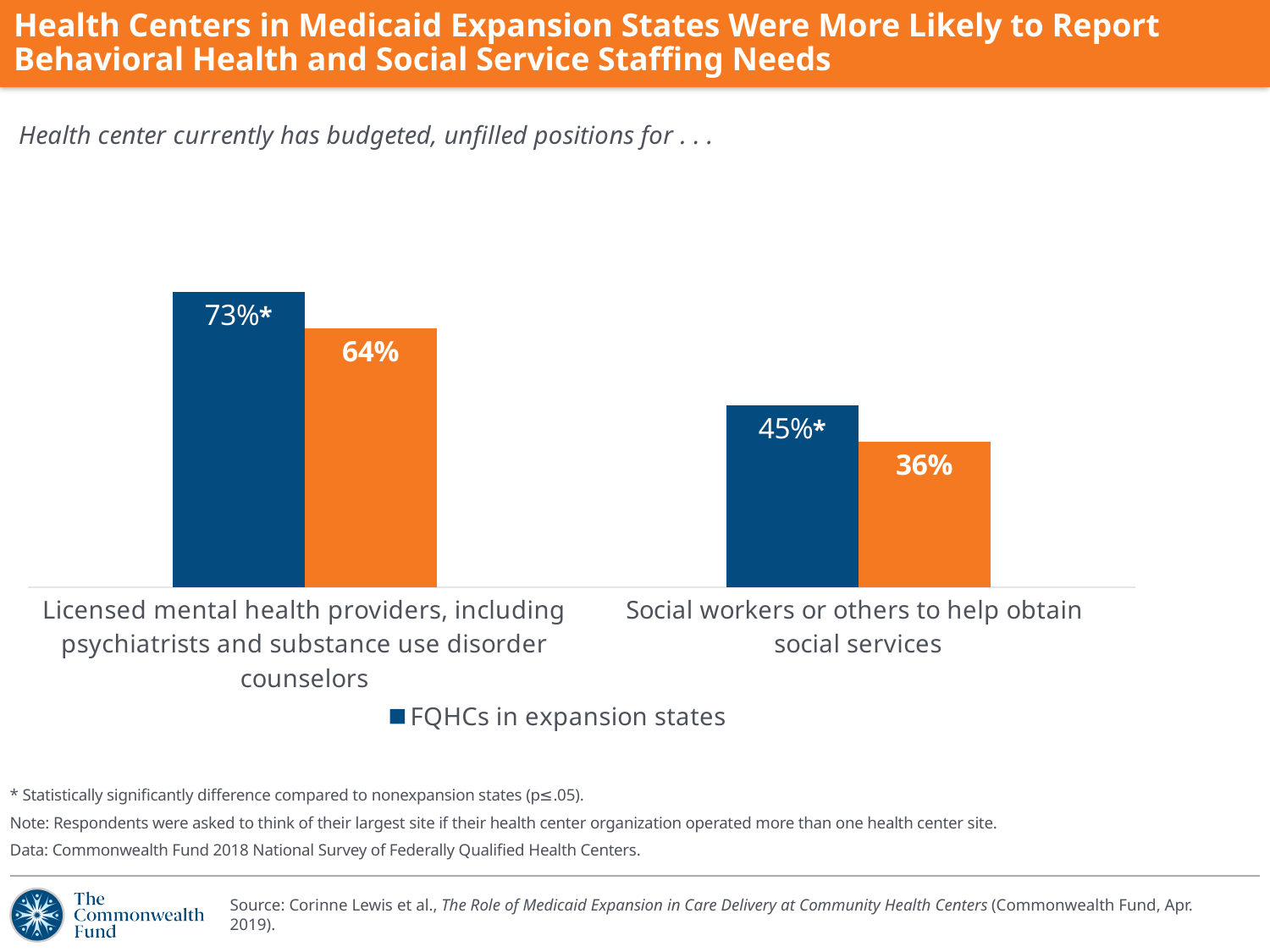
For social workers or others to help obtain social services, what is the difference between the blue bar and the orange bar? 9 percentage points How many categories are shown on the x axis of the chart? 2 What value is shown on the orange bar for licensed mental health providers, including psychiatrists and substance use disorder counselors? 64% What percentage of FQHCs in expansion states report budgeted, unfilled positions for licensed mental health providers, including psychiatrists and substance use disorder counselors? 73% What series name does the chart legend list? FQHCs in expansion states For licensed mental health providers, how many percentage points higher is the blue bar (FQHCs in expansion states) than the orange bar? 9 percentage points For FQHCs in expansion states, which category has the larger value: licensed mental health providers or social workers? Licensed mental health providers What value is shown on the orange bar for social workers or others to help obtain social services? 36% What is the highest value shown on the chart? 73% What kind of chart is shown on the slide? Bar chart What percentage of FQHCs in expansion states report budgeted, unfilled positions for social workers or others to help obtain social services? 45% What is the lowest value shown on the chart? 36%